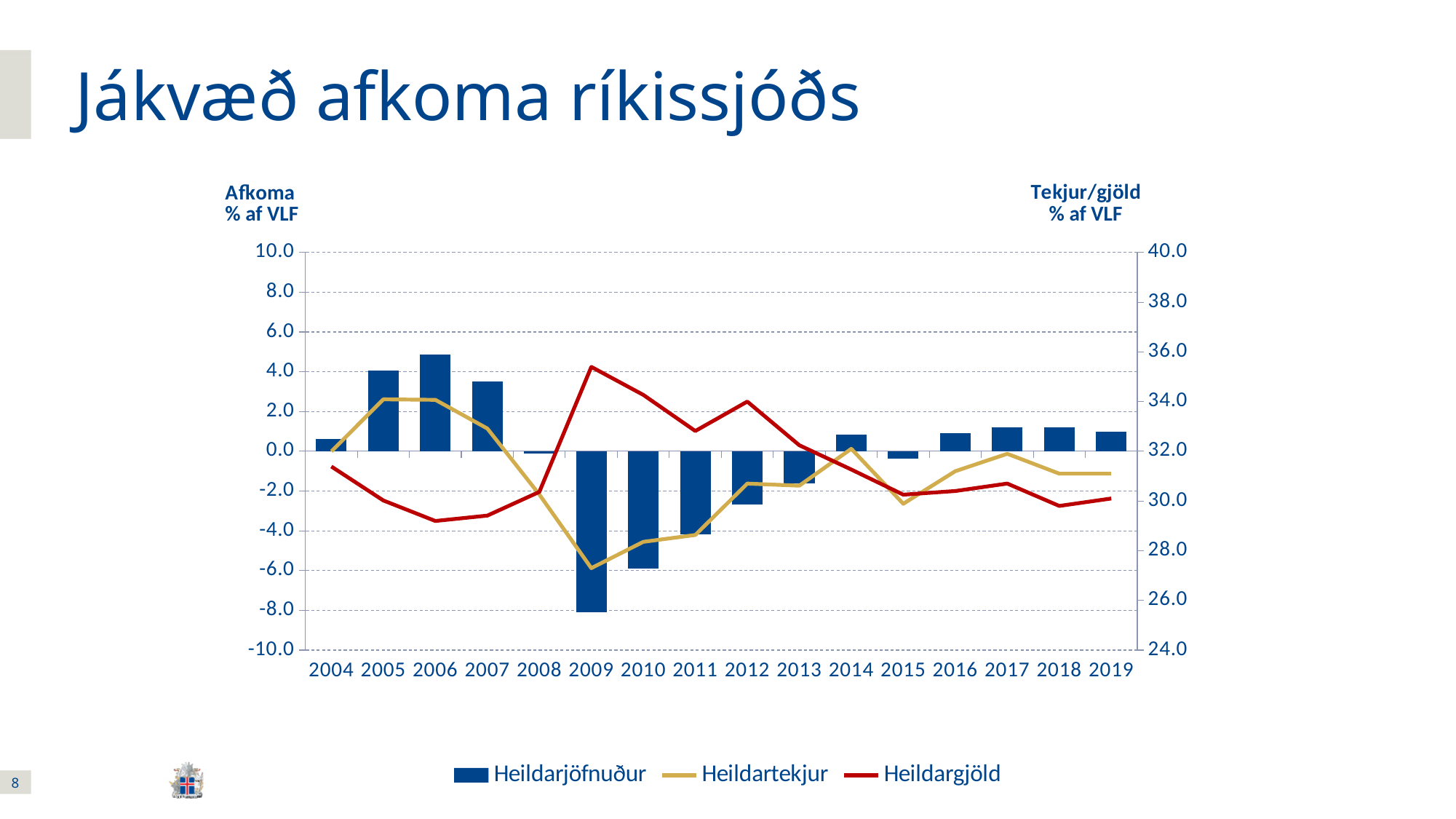
In which year does the Heildartekjur line reach its lowest point? 2009 What kind of chart is shown on the slide? A combined bar and line chart Is the Heildarjöfnuður value for 2005 greater or less than 2.0? greater Is the Heildarjöfnuður value for 2009 greater or less than -6.0? less Do the Heildarjöfnuður bars rise or fall from 2009 to 2014? rise How many series does the legend list? 3 In which year is the Heildarjöfnuður bar lowest? 2009 Which year has the larger Heildarjöfnuður bar, 2005 or 2007? 2005 Is the Heildargjöld value for 2009 greater or less than 34.0 on the right axis? greater In which year does the Heildargjöld line reach its highest point? 2009 In which year is the Heildarjöfnuður bar highest? 2006 How many years are shown on the x axis? 16